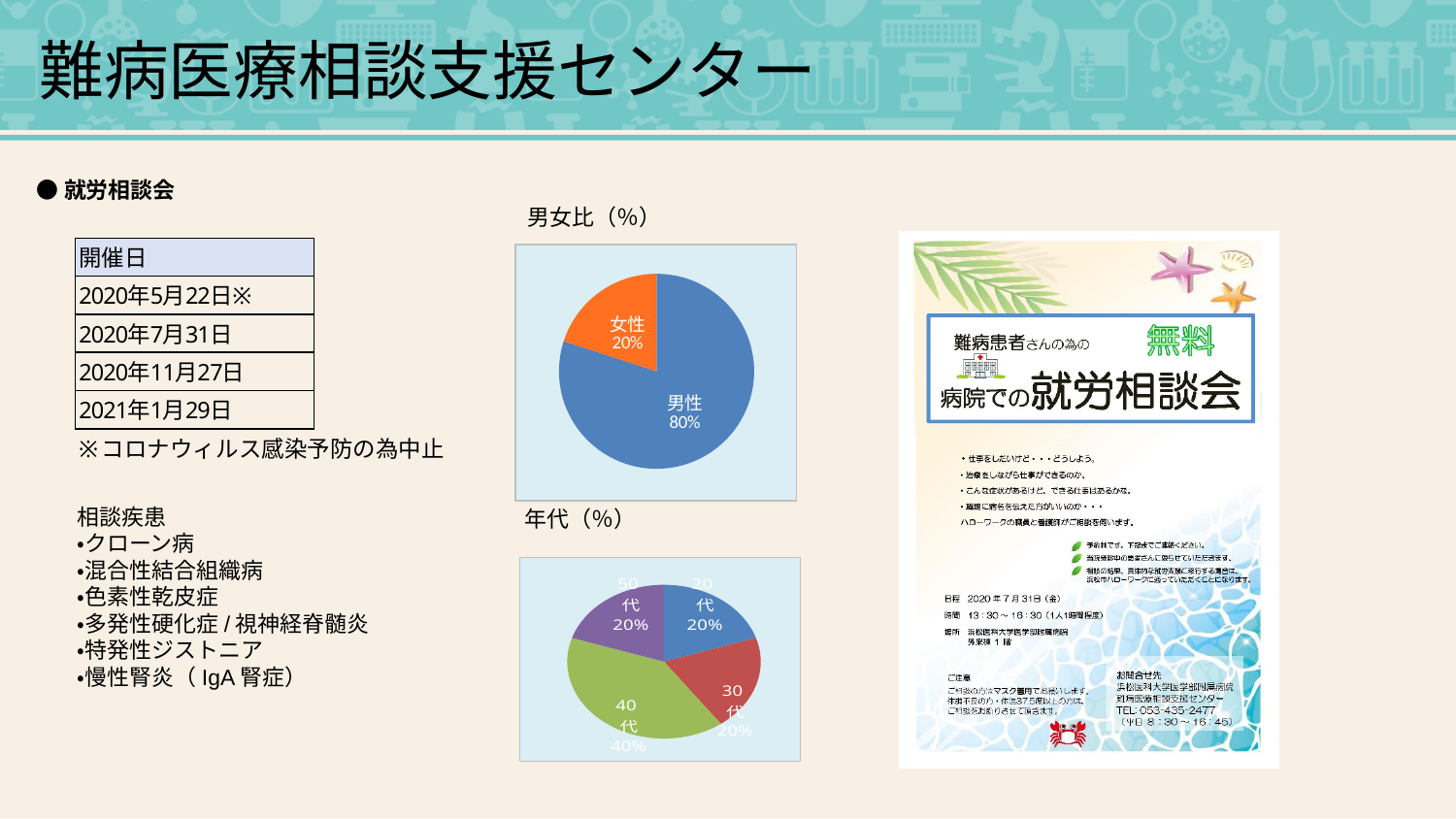
What kind of chart is the 男女比（%） chart? Pie chart How many age groups are shown in the 年代（%） chart? 4 In the 男女比（%） chart, what is the difference between the 男性 and 女性 shares? 60% In the 男女比（%） chart, what percentage is 男性? 80% How many slices does the 男女比（%） chart have? 2 In the 年代（%） chart, what percentage is 40代? 40% In the 男女比（%） chart, which category has the larger share? 男性 In the 年代（%） chart, what is the difference between the 40代 and 50代 shares? 20% In the 年代（%） chart, is the share for 40代 larger than the share for 20代? Yes In the 男女比（%） chart, what percentage is 女性? 20% In the 年代（%） chart, what percentage is 30代? 20% In the 年代（%） chart, which age group has the largest share? 40代